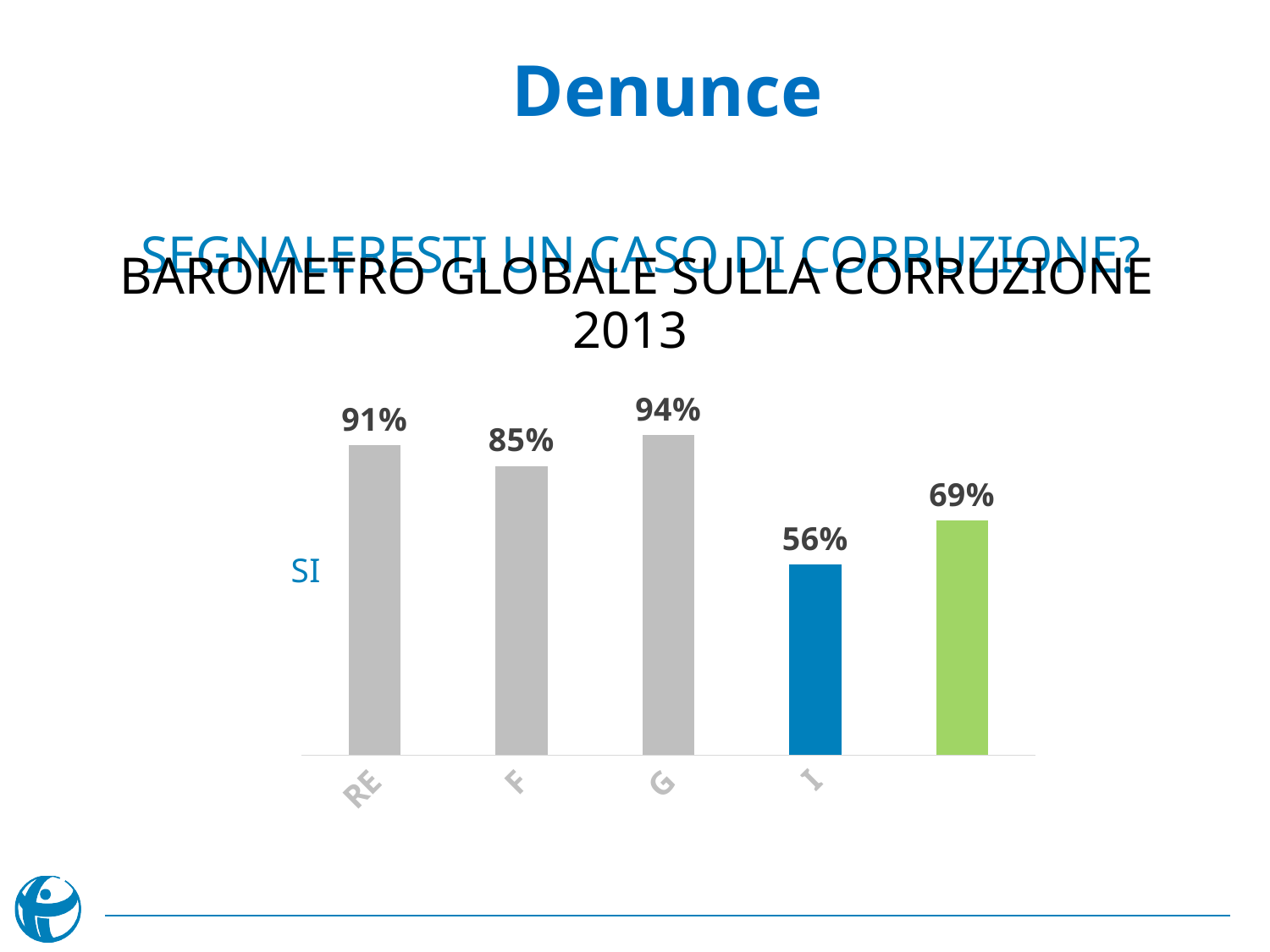
How many bars are plotted in the chart? 5 What is the difference between the values for RE and F? 6 percentage points What is the value for RE? 91% What is the value shown on the rightmost bar of the chart? 69% Which category has the highest value? G What is the value for I? 56% What is the difference between the values for G and I? 38 percentage points What kind of chart is shown on the slide? Bar chart What is the value for F? 85% Which category has the lowest value? I What is the value for G? 94% Which is larger, the value for RE or the value for F? RE